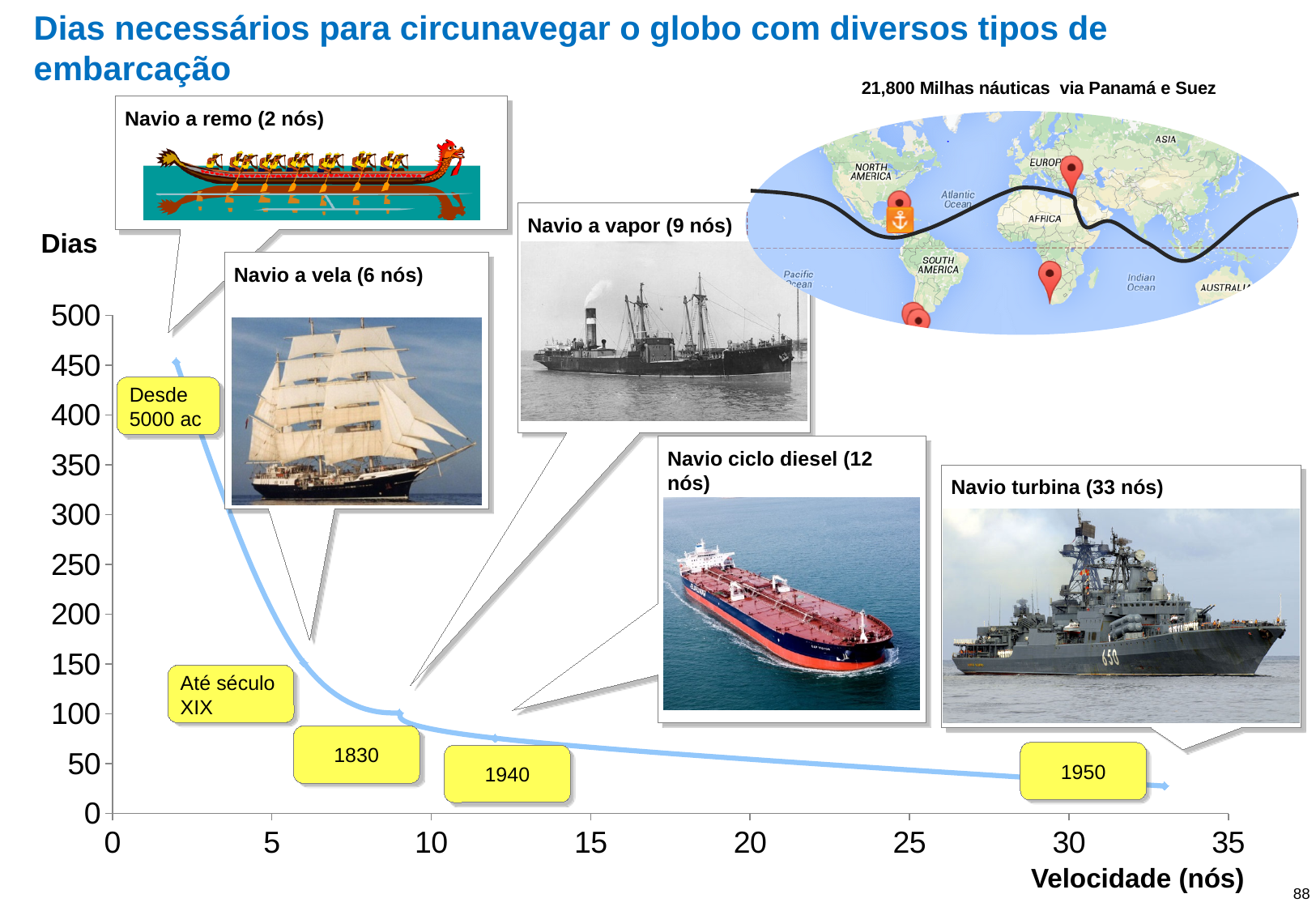
Is the number of days for the turbine ship (33 nós) greater or less than 50? less Which type of vessel requires the most days to circumnavigate the globe? Navio a remo (2 nós) What kind of chart is shown on the slide? line chart Is the number of days for the sailing ship (6 nós) greater or less than 200? less Which requires more days to circumnavigate the globe, the rowing ship (2 nós) or the steam ship (9 nós)? Navio a remo (2 nós) Which type of vessel requires the fewest days to circumnavigate the globe? Navio turbina (33 nós) What is the label of the y axis? Dias Is the number of days for the rowing ship (2 nós) greater or less than 400? greater Do the days needed to circumnavigate the globe rise or fall as speed in knots increases along the x axis? fall What is the label of the x axis? Velocidade (nós) How many types of vessel are labelled on the chart? 5